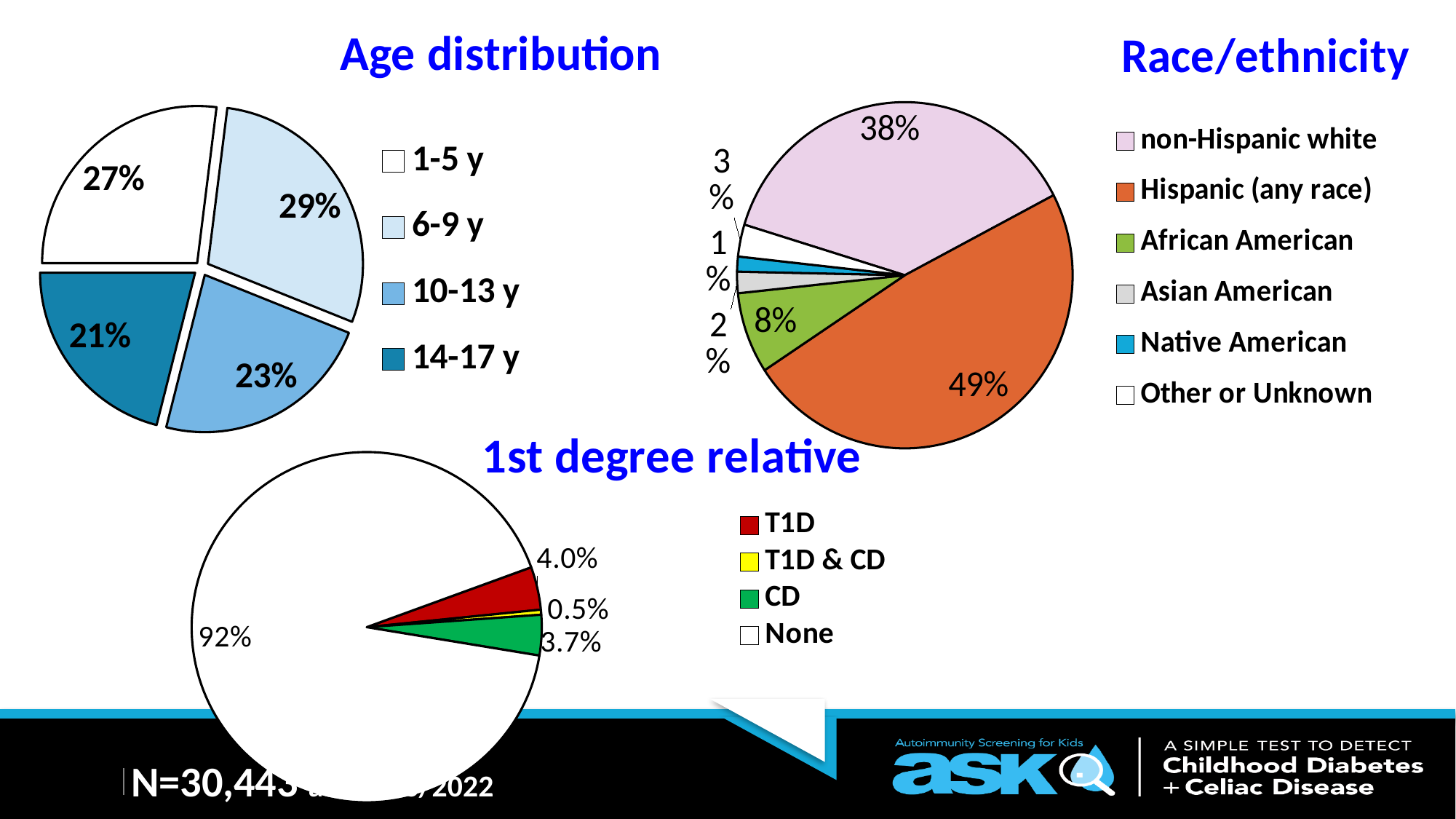
What type of chart is the 1st degree relative chart? pie chart In the Age distribution chart, what percentage is the 6-9 y slice? 29% In the Age distribution chart, what is the difference between the 1-5 y and 10-13 y shares? 4% In the 1st degree relative chart, what percentage is T1D? 4.0% In the Race/ethnicity chart, what percentage is African American? 8% How many slices does the Age distribution chart have? 4 How many categories does the legend of the Race/ethnicity chart list? 6 In the Race/ethnicity chart, is the non-Hispanic white share larger or smaller than the Hispanic (any race) share? smaller In the Race/ethnicity chart, which category has the largest share? Hispanic (any race) In the Age distribution chart, which age group has the smallest share? 14-17 y In the Race/ethnicity chart, what percentage is Hispanic (any race)? 49% In the Age distribution chart, which age group has the largest share? 6-9 y